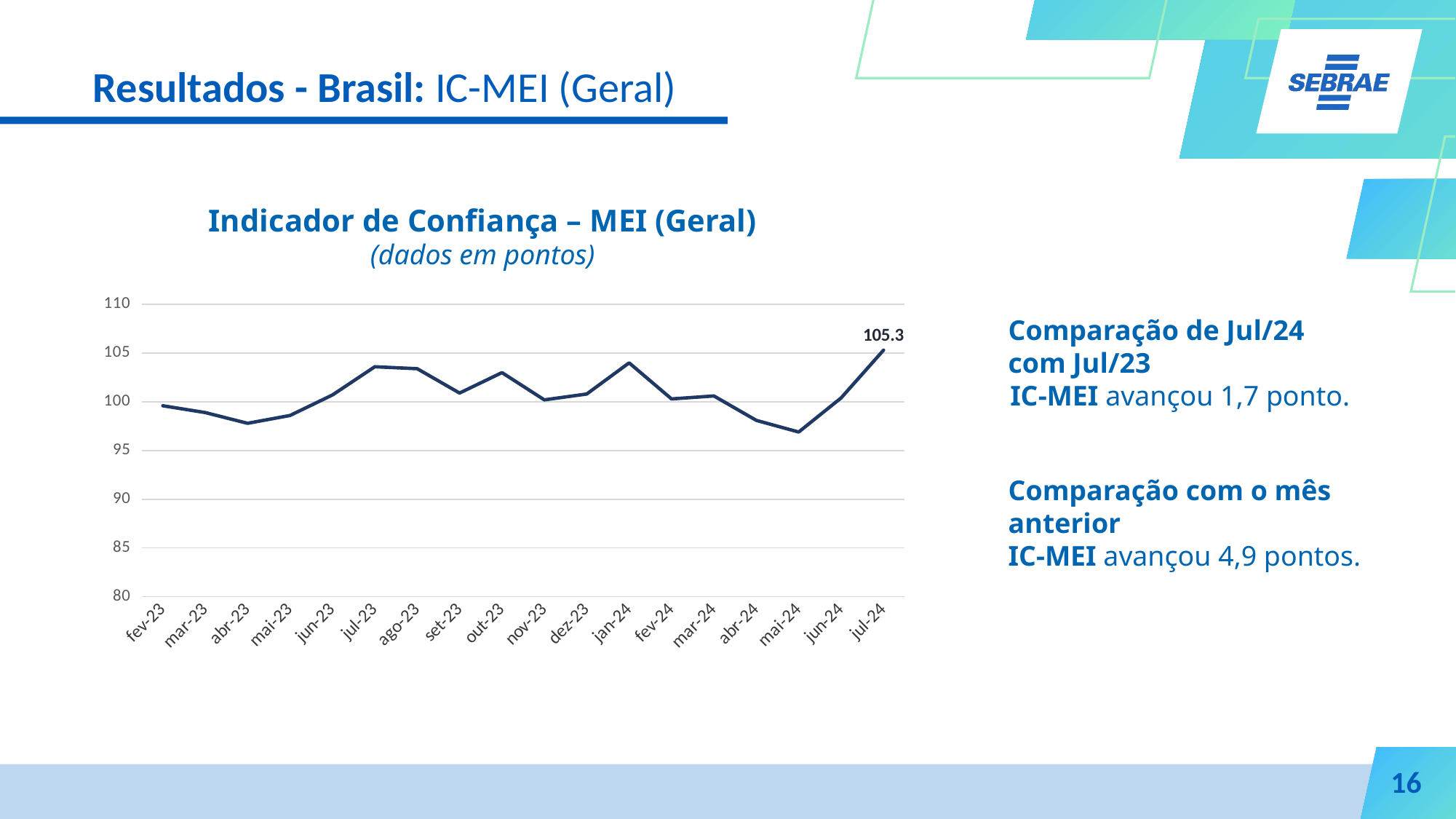
Which is larger, the value for jul-24 or the value for mai-24? jul-24 Is the value for jul-23 greater or less than 100? greater How many months are plotted on the x axis of the chart? 18 Is the value for abr-23 greater or less than 100? less Is the value for mai-24 greater or less than 100? less What is the title of the chart? Indicador de Confiança – MEI (Geral) What is the value for jul-24 in the chart? 105.3 What kind of chart is shown on the slide? line chart Which month has the highest value in the chart? jul-24 Which month has the lowest value in the chart? mai-24 Do the values rise or fall from mai-24 to jul-24? rise